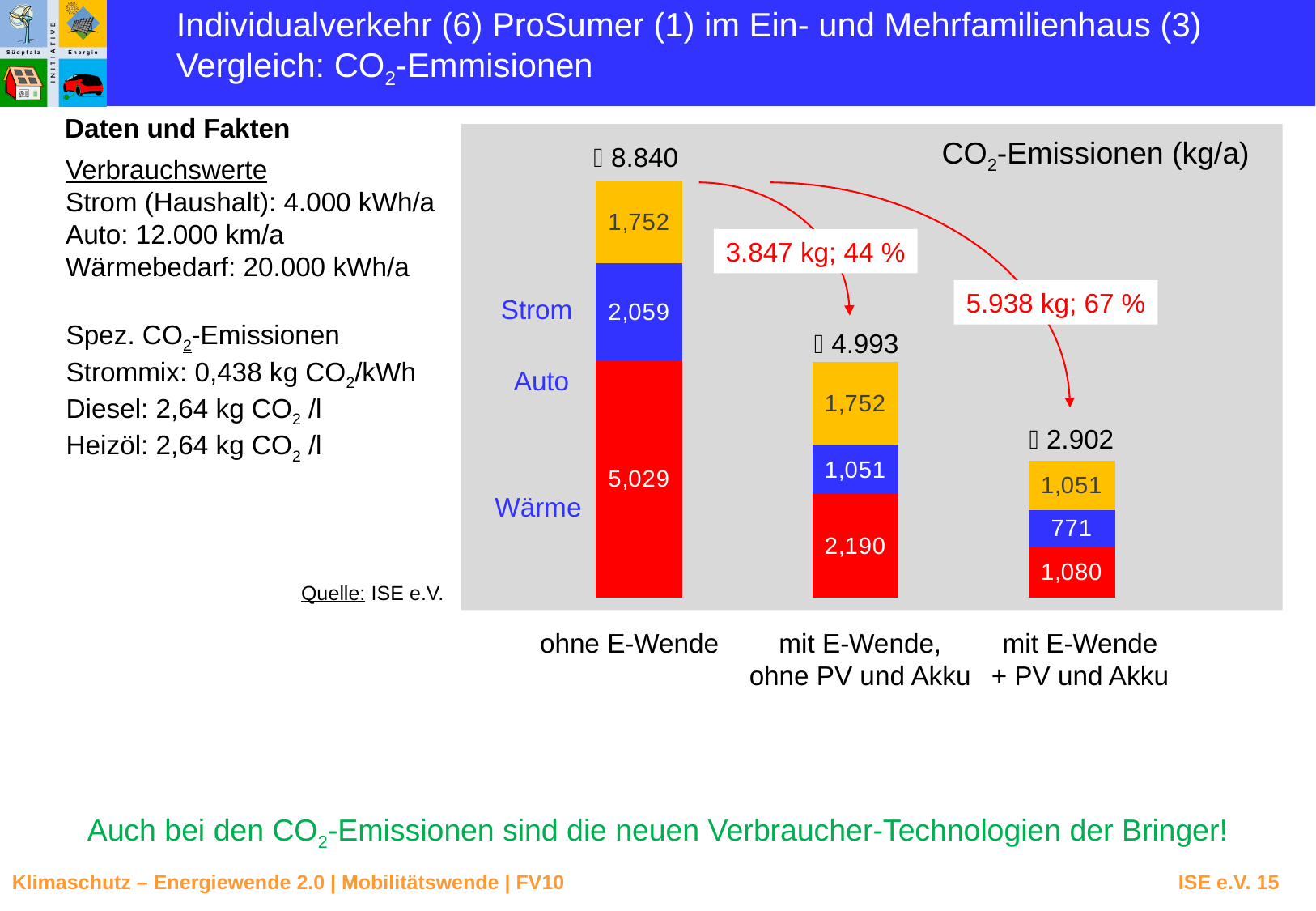
What is the total CO2 emission shown above the 'mit E-Wende + PV und Akku' bar? 2.902 What is the total CO2 emission shown above the 'ohne E-Wende' bar? 8.840 What kind of chart is shown on the slide? Stacked bar chart How many series are labelled on the chart (Strom, Auto, Wärme)? 3 Which is larger: the top (yellow) segment of 'ohne E-Wende' or the top (yellow) segment of 'mit E-Wende + PV und Akku'? ohne E-Wende Which scenario has the highest total CO2 emissions? ohne E-Wende What is the value of the bottom (red) segment of the 'ohne E-Wende' bar? 5,029 By how many kg do the emissions fall from 'ohne E-Wende' to 'mit E-Wende, ohne PV und Akku', as annotated on the chart? 3.847 kg Which scenario has the lowest total CO2 emissions? mit E-Wende + PV und Akku What is the value of the middle (blue) segment of the 'mit E-Wende, ohne PV und Akku' bar? 1,051 How many bars (scenarios) does the chart show? 3 Do the total emissions rise or fall from left to right across the three scenarios? Fall